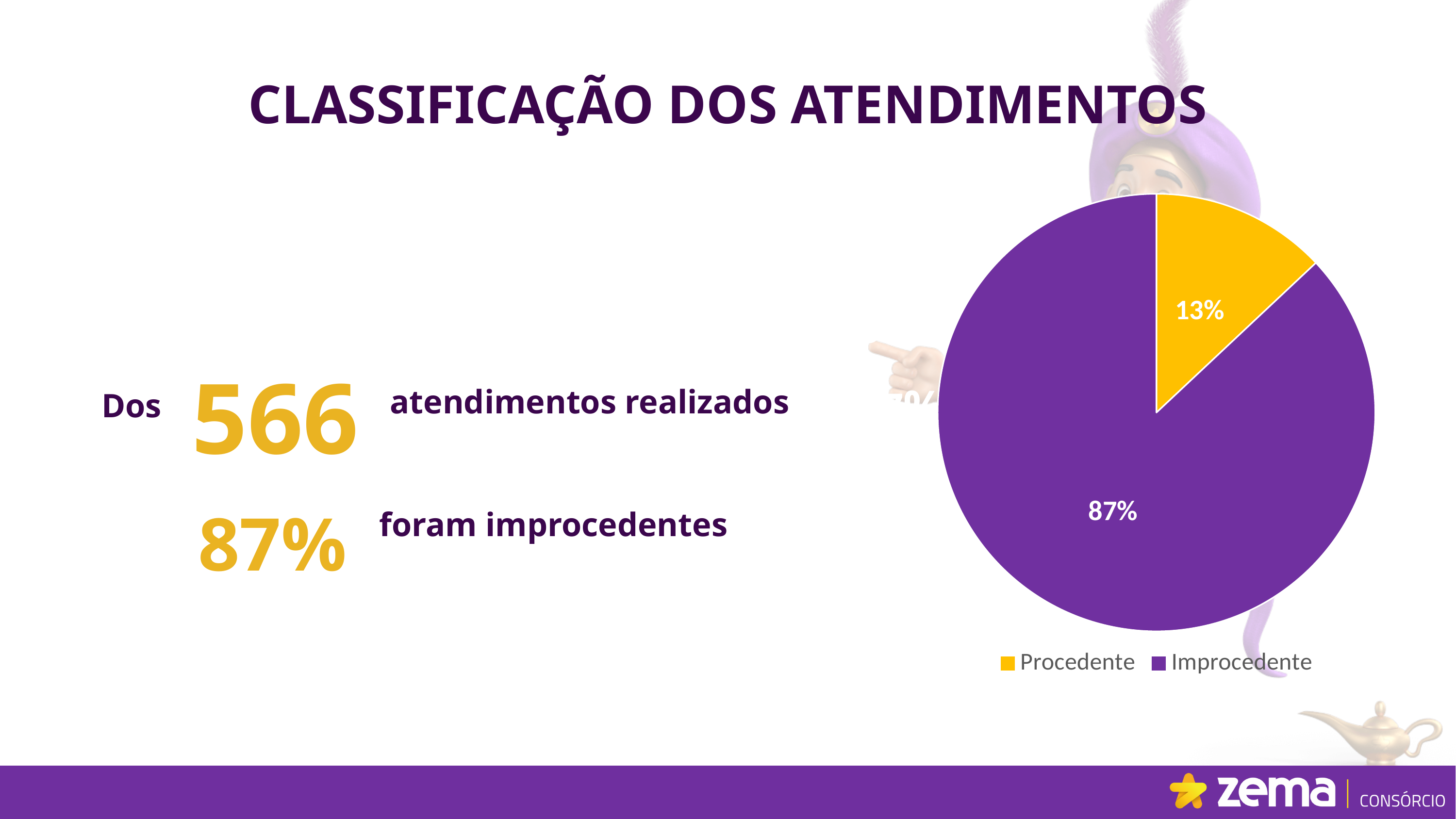
What share of the pie does Procedente represent? 13% How many categories does the pie chart show? 2 Which slice is larger, Procedente or Improcedente? Improcedente What colour is the Procedente slice? yellow What is the difference in percentage points between the Improcedente and Procedente slices? 74 How many entries does the legend list? 2 What kind of chart is shown on the slide? pie chart Is the value for Procedente greater or less than 50%? less Which category has the smallest slice of the pie? Procedente What colour is the Improcedente slice? purple What share of the pie does Improcedente represent? 87% Which category has the largest slice of the pie? Improcedente